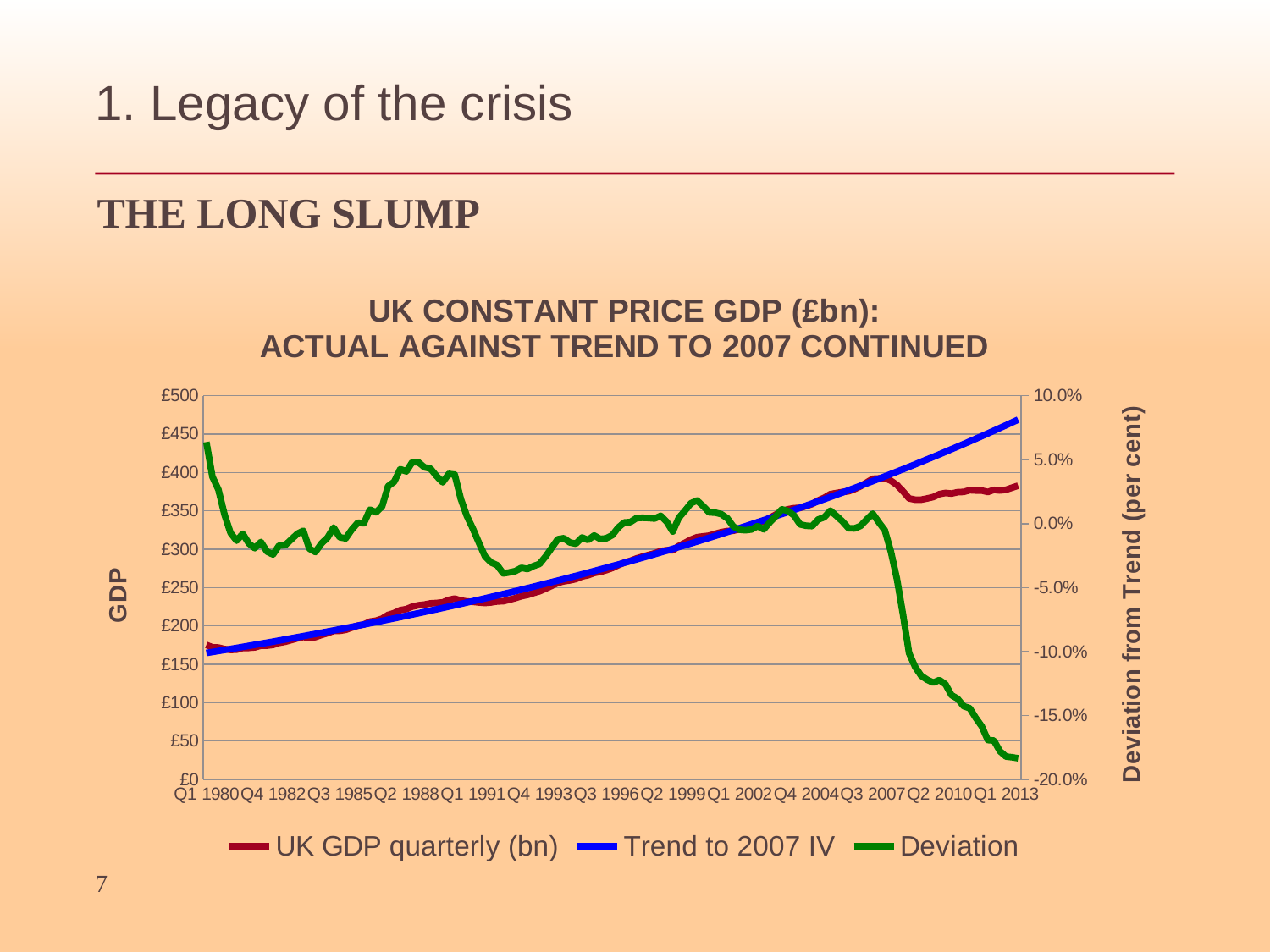
Does the Trend to 2007 IV line rise or fall from Q1 1980 to Q1 2013? rise Is the value of the UK GDP quarterly (bn) line at Q1 1980 greater or less than £200? less What is the title of the chart? UK CONSTANT PRICE GDP (£bn): ACTUAL AGAINST TREND TO 2007 CONTINUED What kind of chart is shown on the slide? line chart Is the value of the Deviation line at Q1 2013 greater or less than -15.0%? less Is the value of the UK GDP quarterly (bn) line at Q1 2013 greater or less than £350? greater At Q1 2013, which is higher: the UK GDP quarterly (bn) line or the Trend to 2007 IV line? Trend to 2007 IV What is the label of the right-hand vertical axis? Deviation from Trend (per cent) Does the Deviation line rise or fall from Q3 2007 to Q1 2013? fall How many series does the legend list? 3